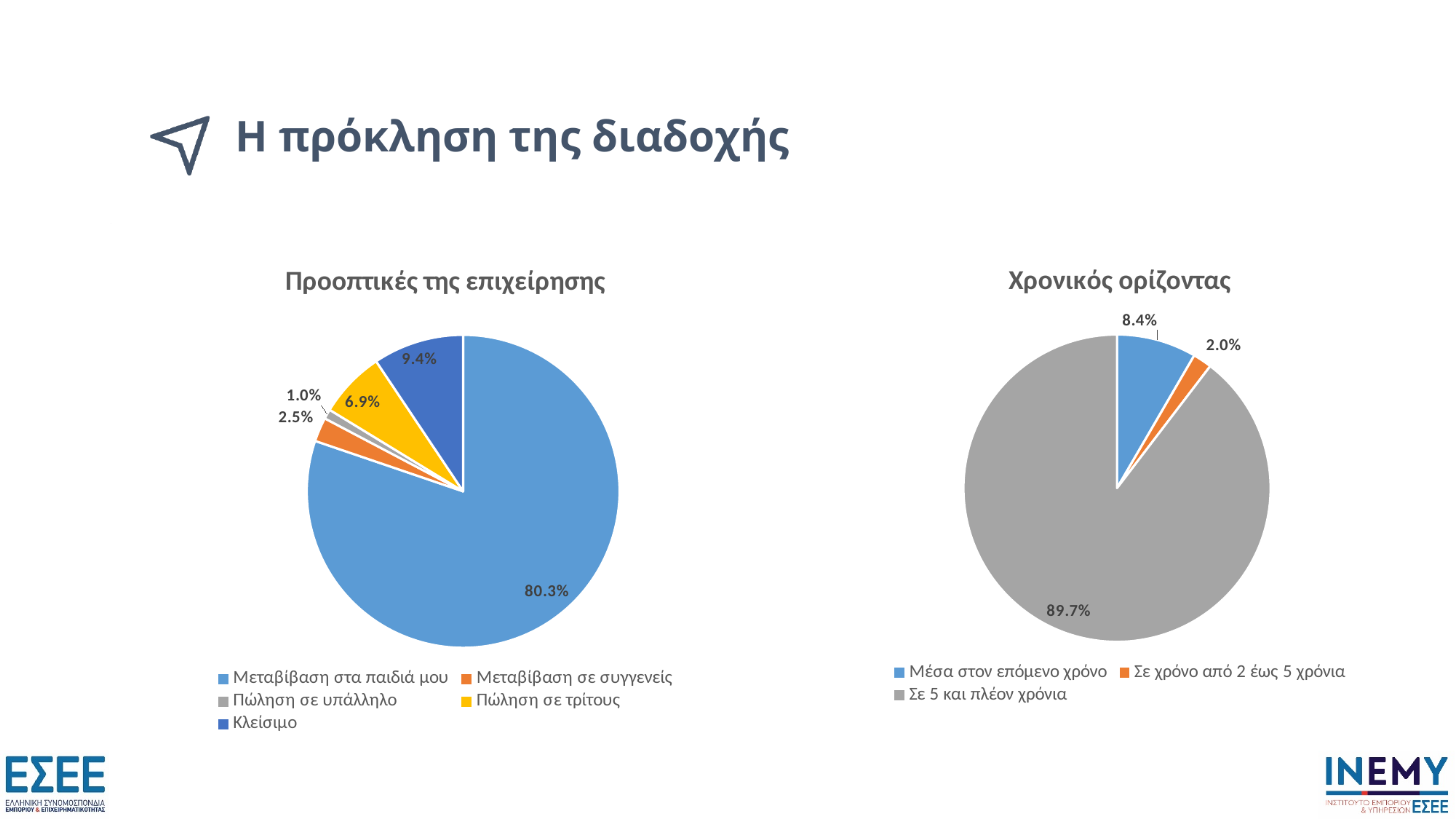
In the chart titled 'Προοπτικές της επιχείρησης', what is the difference between 'Κλείσιμο' and 'Πώληση σε τρίτους'? 2.5% In the chart titled 'Προοπτικές της επιχείρησης', which is larger: 'Μεταβίβαση σε συγγενείς' or 'Πώληση σε τρίτους'? Πώληση σε τρίτους In the chart titled 'Προοπτικές της επιχείρησης', what is the value for 'Μεταβίβαση στα παιδιά μου'? 80.3% In the chart titled 'Προοπτικές της επιχείρησης', which category has the smallest slice? Πώληση σε υπάλληλο In the chart titled 'Προοπτικές της επιχείρησης', how many slices does the pie have? 5 In the chart titled 'Χρονικός ορίζοντας', which category has the largest slice? Σε 5 και πλέον χρόνια In the chart titled 'Προοπτικές της επιχείρησης', what is the value for 'Κλείσιμο'? 9.4% In the chart titled 'Χρονικός ορίζοντας', what is the value for 'Μέσα στον επόμενο χρόνο'? 8.4% In the chart titled 'Χρονικός ορίζοντας', what is the value for 'Σε 5 και πλέον χρόνια'? 89.7% In the chart titled 'Χρονικός ορίζοντας', what is the difference between 'Μέσα στον επόμενο χρόνο' and 'Σε χρόνο από 2 έως 5 χρόνια'? 6.4% In the chart titled 'Προοπτικές της επιχείρησης', what is the value for 'Πώληση σε τρίτους'? 6.9% What type of chart is the chart titled 'Χρονικός ορίζοντας'? Pie chart